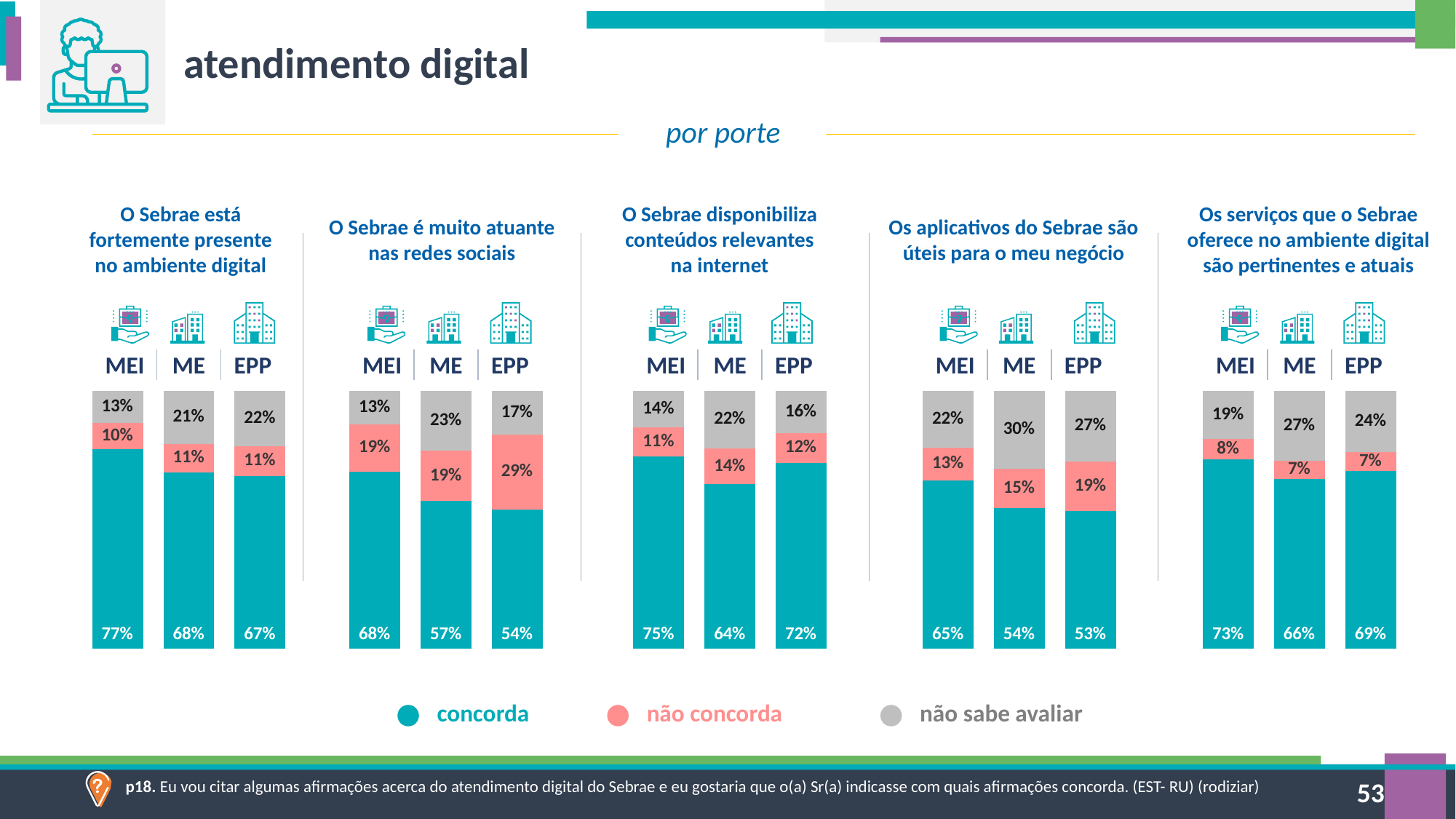
What kind of chart is used on the slide? Stacked bar chart Which colour represents "não concorda" in the legend? Pink In the chart titled "Os serviços que o Sebrae oferece no ambiente digital são pertinentes e atuais", which category has the lowest "concorda" value? ME In the chart titled "Os aplicativos do Sebrae são úteis para o meu negócio", what is the "não sabe avaliar" value for ME? 30% In the chart titled "O Sebrae está fortemente presente no ambiente digital", what is the total of the stacked bar for MEI? 100% In the chart titled "O Sebrae é muito atuante nas redes sociais", what is the "não concorda" value for EPP? 29% In the chart titled "O Sebrae está fortemente presente no ambiente digital", what is the "concorda" value for MEI? 77% How many categories are shown in each chart on the slide? 3 How many series does the legend list? 3 In the chart titled "O Sebrae é muito atuante nas redes sociais", what is the difference between the "concorda" values for MEI and EPP? 14% In the chart titled "Os aplicativos do Sebrae são úteis para o meu negócio", which is larger: the "não concorda" value for ME or for EPP? EPP In the chart titled "O Sebrae disponibiliza conteúdos relevantes na internet", which category has the highest "concorda" value? MEI